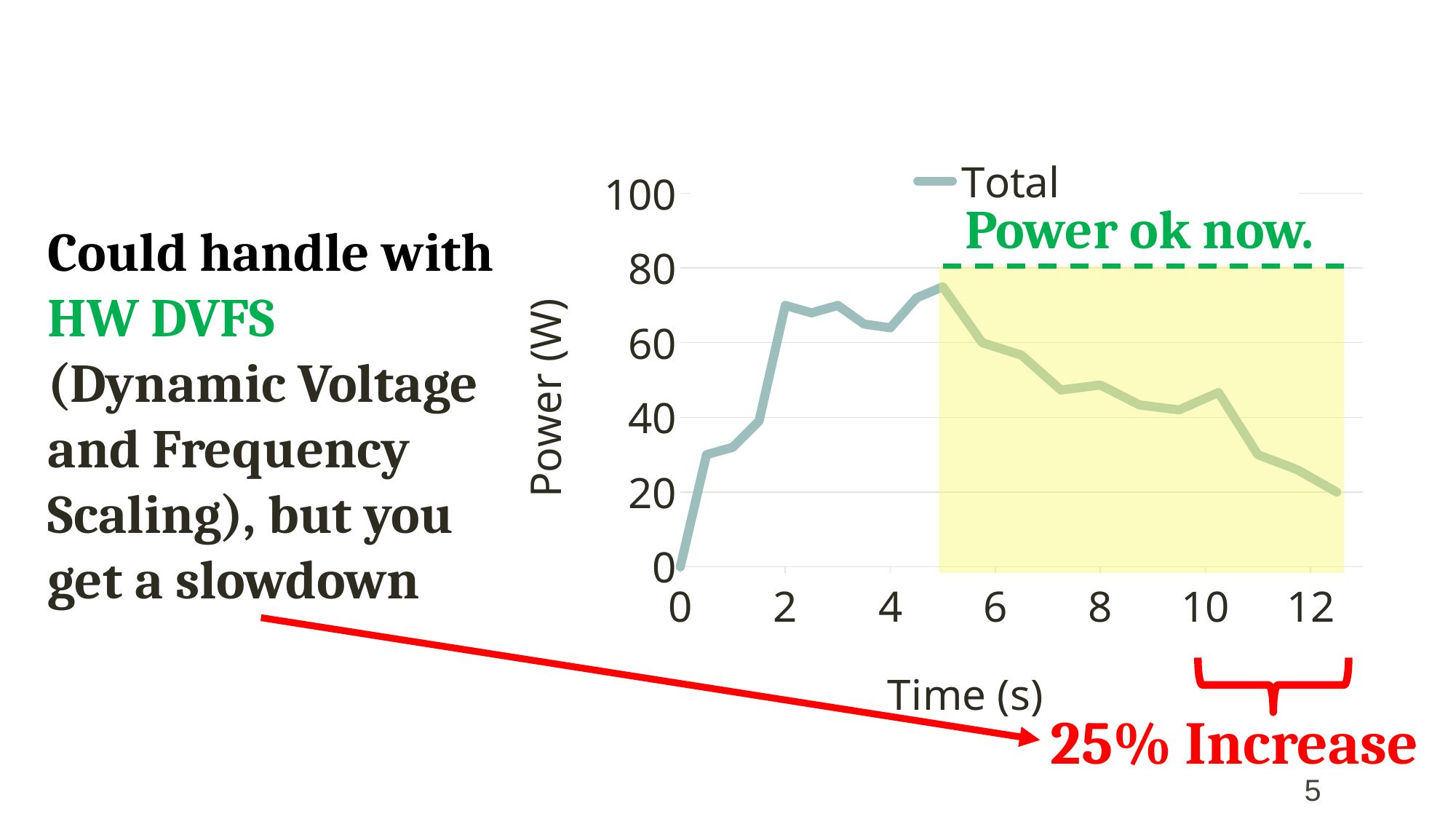
Which is larger, the Total power at 2 s or at 12 s? 2 s How many series does the chart legend list? 1 At which time is the Total power lowest? 0 s What is the label of the vertical axis of the chart? Power (W) What is the value of Total at time 0 s? 0 Is the value of Total at 12 s greater or less than 40? less Is the value of Total at 5 s greater or less than 80? less What is the name of the series shown in the chart legend? Total What kind of chart is shown on the slide? line chart Is the value of Total at 2 s greater or less than 60? greater Does the Total power rise or fall between 5 s and 12 s? fall Does the Total power rise or fall between 0 s and 2 s? rise